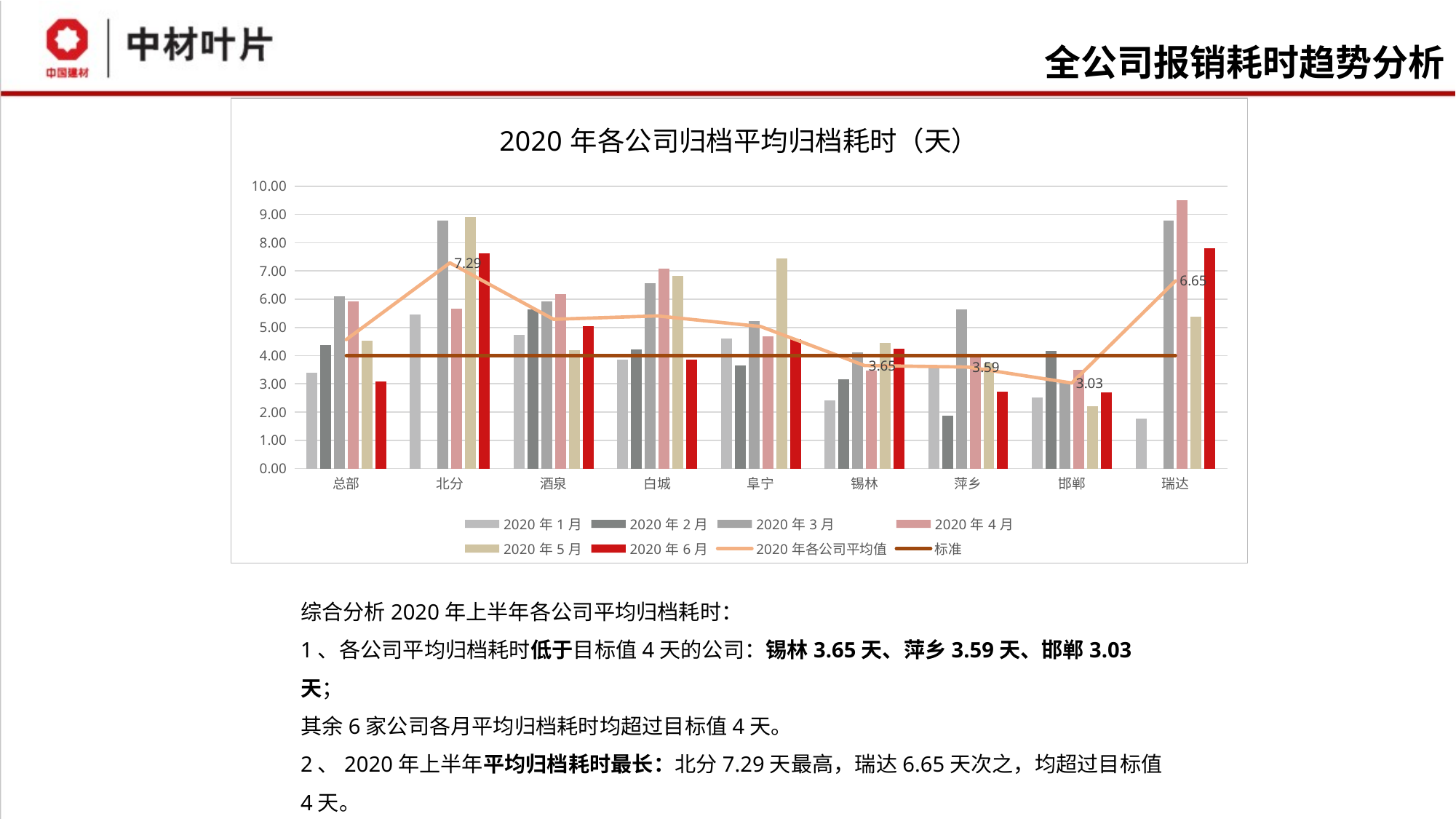
What is the 2020 年各公司平均值 for 北分? 7.29 How many companies (categories) are shown on the x axis? 9 What is the title of the chart? 2020 年各公司归档平均归档耗时（天） How many series does the legend list? 8 What is the 2020 年各公司平均值 for 瑞达? 6.65 What is the difference between the 2020 年各公司平均值 for 北分 and for 瑞达? 0.64 What is the 2020 年各公司平均值 for 邯郸? 3.03 Which is larger, the 2020 年各公司平均值 for 锡林 or for 萍乡? 锡林 What kind of chart is shown on the slide? bar chart with line series Which company has the highest 2020 年各公司平均值? 北分 Is the 2020 年6月 value for 总部 greater or less than 4.00? less Which company has the lowest 2020 年各公司平均值? 邯郸